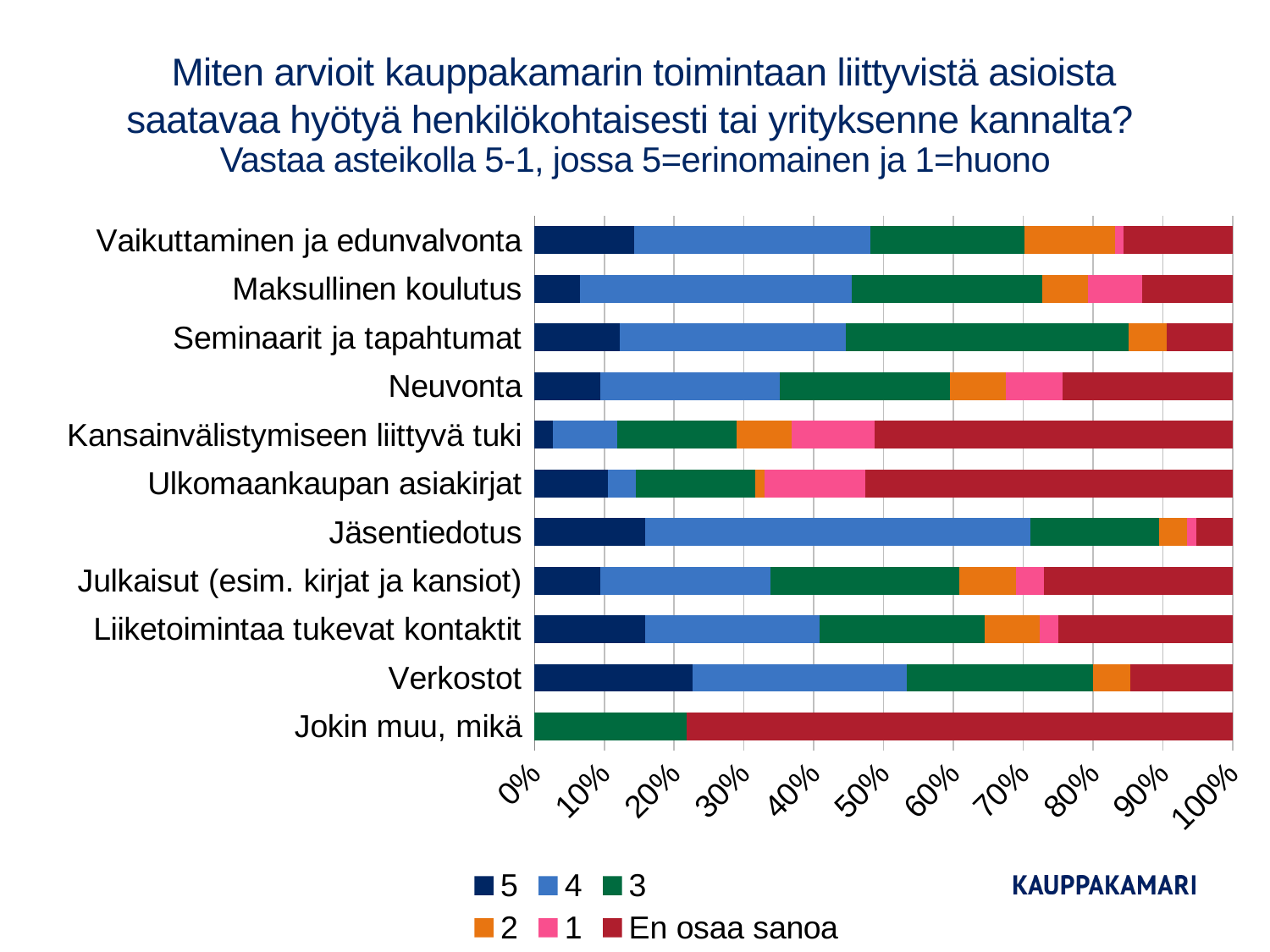
Is the share of '4' responses for Jäsentiedotus greater or less than 50%? greater What kind of chart is shown on the slide? Stacked bar chart Which has a larger share of '5' responses, Verkostot or Maksullinen koulutus? Verkostot Which category has the largest share of '4' (light blue) responses? Jäsentiedotus Is the share of 'En osaa sanoa' responses for Jokin muu, mikä greater or less than 70%? greater Which category has the largest share of '5' (dark blue) responses? Verkostot How many categories are listed on the vertical axis of the chart? 11 How many series does the legend list? 6 Which category has the smallest share of 'En osaa sanoa' responses? Jäsentiedotus Is the share of '3' responses for Jokin muu, mikä greater or less than 30%? less Which category has the largest share of 'En osaa sanoa' responses? Jokin muu, mikä What are the legend entries of the chart? 5, 4, 3, 2, 1, En osaa sanoa